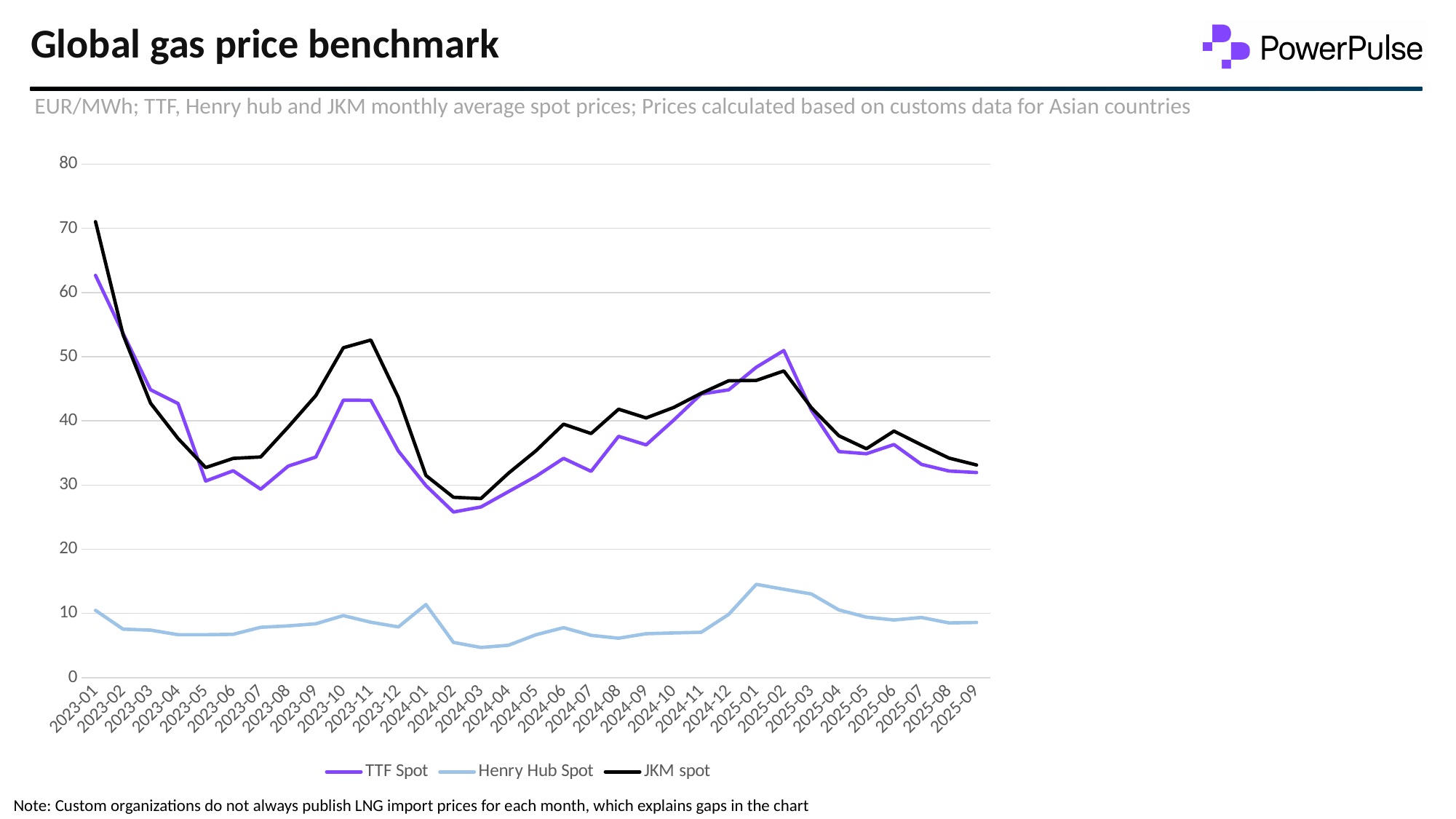
In which month does the Henry Hub Spot series reach its highest value? 2025-01 Is the JKM spot value for 2023-01 greater or less than 60? greater How many series does the legend list? 3 What kind of chart is shown on the slide? Line chart Is the Henry Hub Spot value for 2025-01 greater or less than 10? greater Does the TTF Spot series rise or fall from 2023-01 to 2023-05? Fall In which month does the JKM spot series reach its highest value? 2023-01 In 2023-10, which is higher: JKM spot or TTF Spot? JKM spot How many months are shown along the x axis? 33 What is the title of the chart? Global gas price benchmark Is the TTF Spot value for 2024-02 greater or less than 30? less In which month does the Henry Hub Spot series reach its lowest value? 2024-03